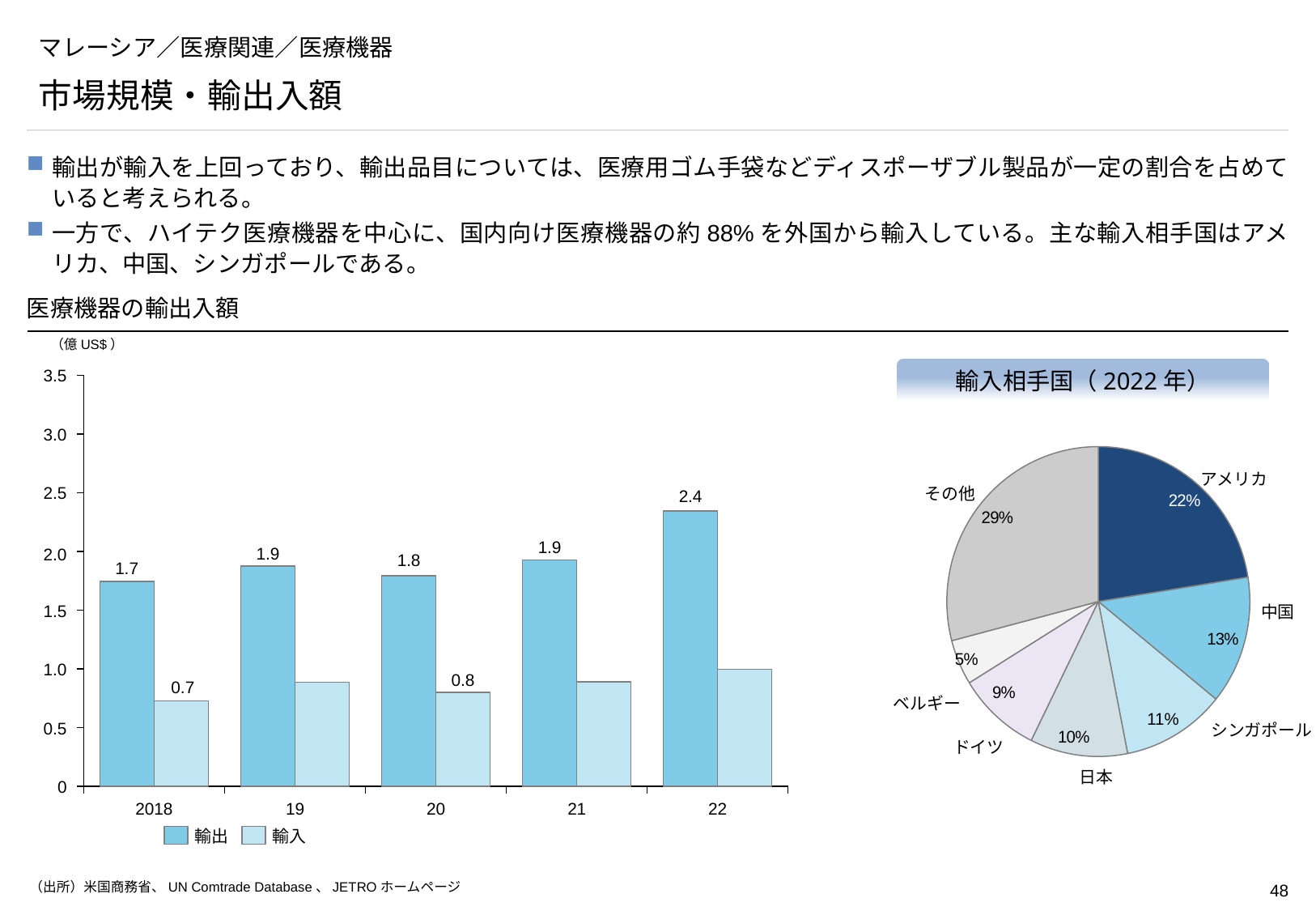
In the pie chart 輸入相手国（2022年）, which slice is the smallest? ベルギー In the bar chart 医療機器の輸出入額, which year has the highest 輸出 value? 22 In the bar chart 医療機器の輸出入額, what is the difference between the 輸出 value for 22 and the 輸出 value for 2018? 0.7 In the bar chart 医療機器の輸出入額, how many series does the legend list? 2 What kind of chart is 医療機器の輸出入額 on the left of the slide? bar chart In the bar chart 医療機器の輸出入額, what is the value of 輸出 for 22? 2.4 In the bar chart 医療機器の輸出入額, which is larger for 20: 輸出 or 輸入? 輸出 In the pie chart 輸入相手国（2022年）, how many slices are there? 7 In the bar chart 医療機器の輸出入額, is the 輸入 value for 19 greater or less than 1.0? less In the pie chart 輸入相手国（2022年）, what share does アメリカ have? 22% In the bar chart 医療機器の輸出入額, what is the value of 輸入 for 2018? 0.7 In the pie chart 輸入相手国（2022年）, which slice is the largest? その他